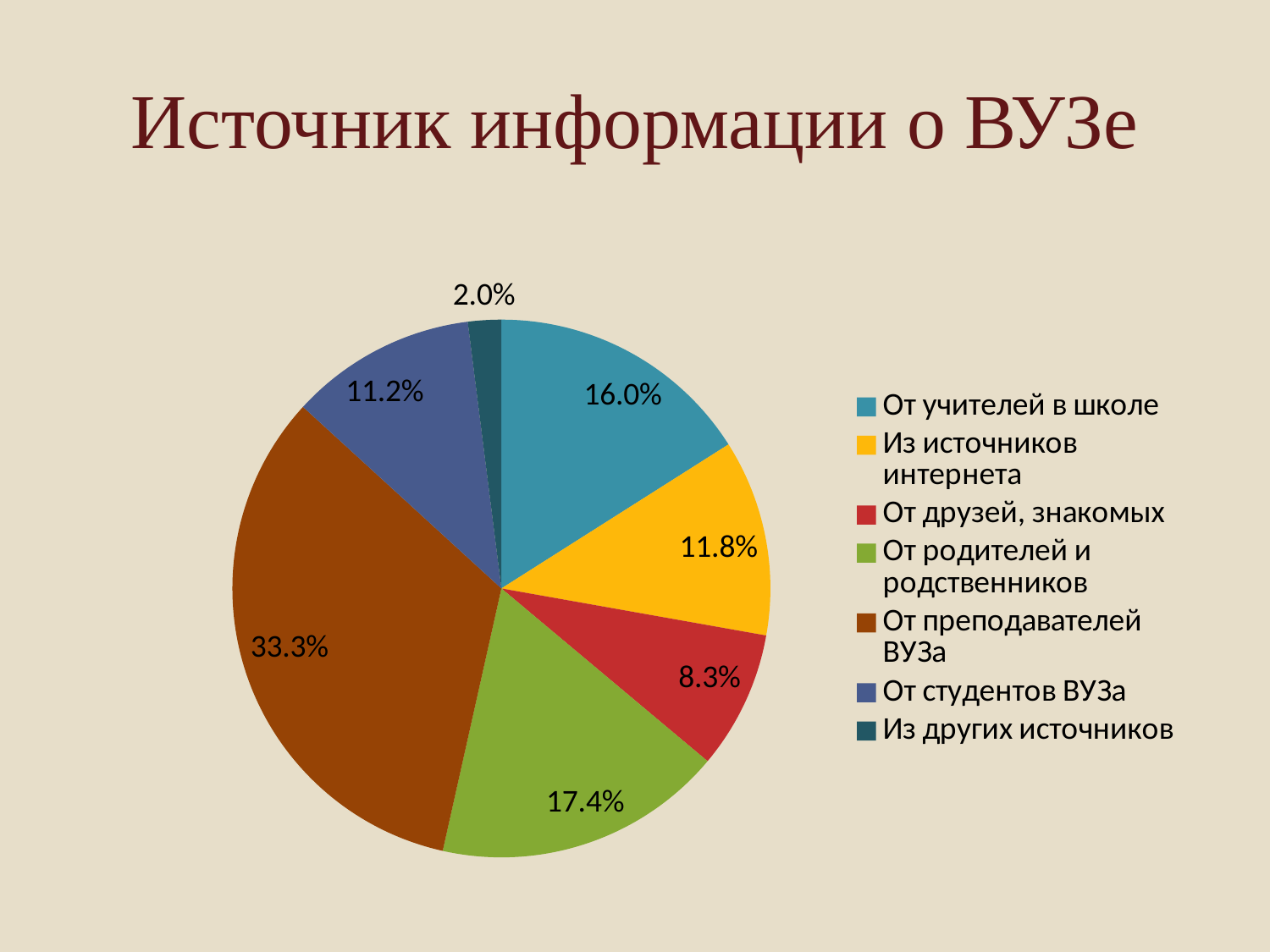
What kind of chart is shown on the slide? pie chart Which category has the largest slice? От преподавателей ВУЗа How many categories does the pie chart have? 7 What is the share for От родителей и родственников? 17.4% What colour is the slice for Из источников интернета? yellow Which category has the smallest slice? Из других источников What is the share for От преподавателей ВУЗа? 33.3% What is the share for От учителей в школе? 16.0% What is the share for Из источников интернета? 11.8% What is the difference between the shares for От преподавателей ВУЗа and От родителей и родственников? 15.9% What is the title of the slide? Источник информации о ВУЗе Which is larger, the share for От друзей, знакомых or the share for От студентов ВУЗа? От студентов ВУЗа